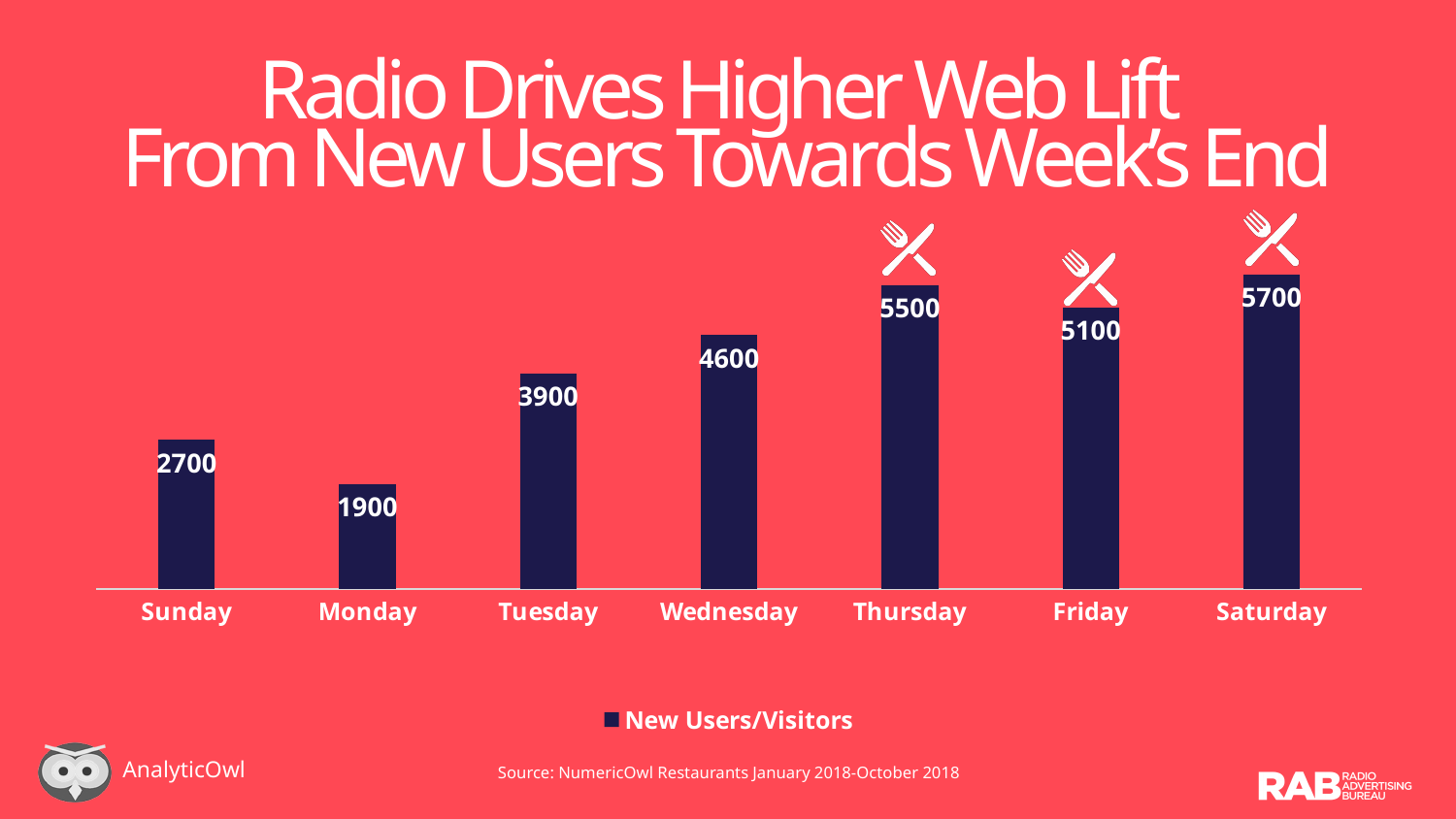
What is the value for New Users/Visitors on Friday? 5100 What is the difference between the values for Thursday and Friday? 400 What is the name of the series shown in the legend? New Users/Visitors Which day has the highest number of New Users/Visitors? Saturday Which day has the lowest number of New Users/Visitors? Monday How many series does the legend list? 1 Which is larger, the value for Tuesday or the value for Sunday? Tuesday What is the value for New Users/Visitors on Monday? 1900 What is the value for New Users/Visitors on Wednesday? 4600 What is the difference between the values for Saturday and Sunday? 3000 How many days are shown on the x axis of the chart? 7 What kind of chart is shown on the slide? Bar chart